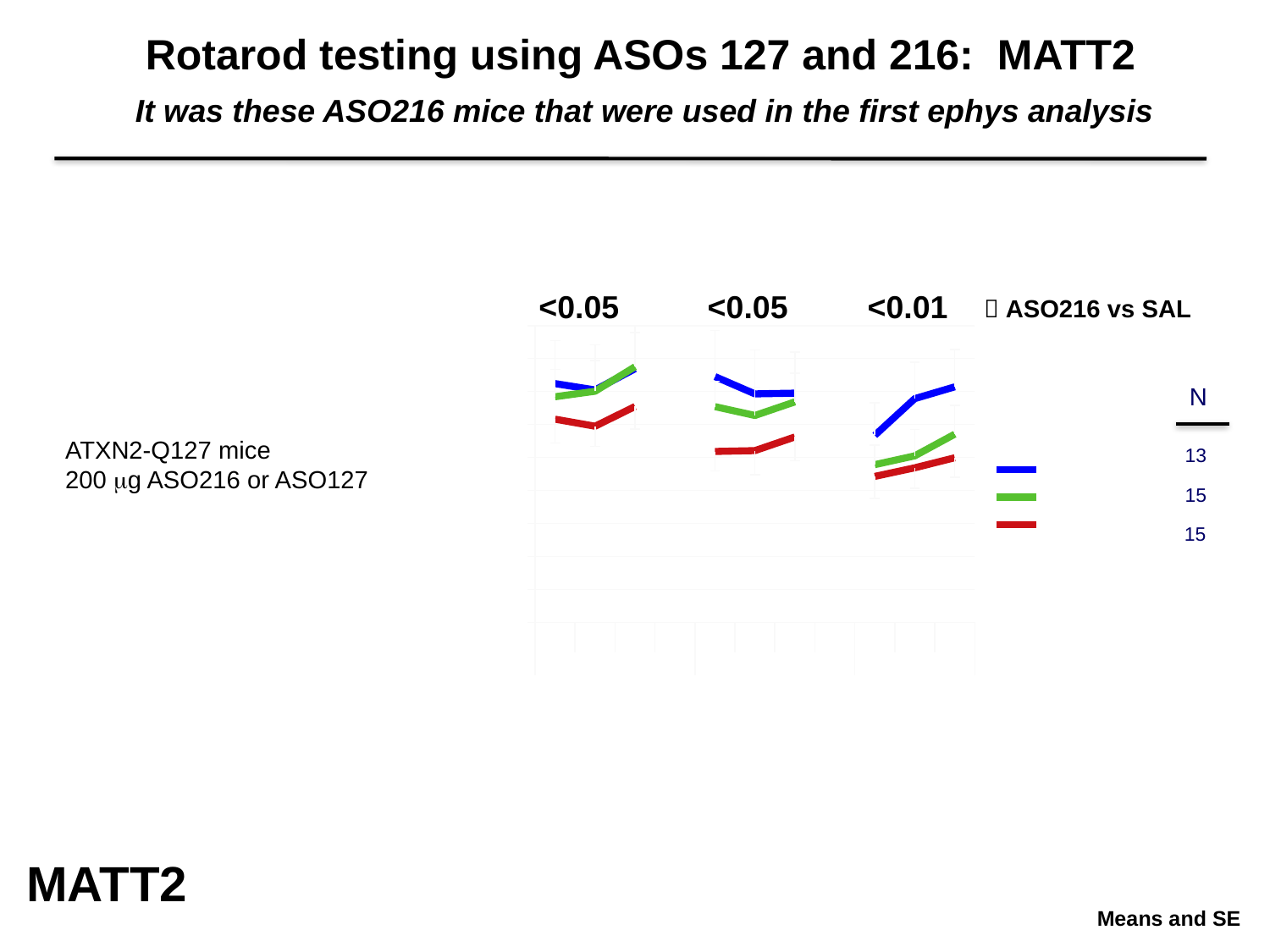
What N value is listed next to the blue line in the legend? 13 How many separate groups of line segments are plotted along the x axis? 3 In the rightmost group, do the lines rise or fall from left to right? rise What p-value is printed above the rightmost group of lines? <0.01 How many coloured series (lines) does the legend on the right list? 3 In the leftmost group, which is higher, the green line or the red line? green In the leftmost group, which coloured line is the lowest? red What kind of chart is shown on the slide? line chart Across the three groups from left to right, does the overall level of the blue line rise or fall? fall In the rightmost group, which coloured line is the highest? blue In the rightmost group, which coloured line is the lowest? red In the middle group, which is higher, the blue line or the red line? blue